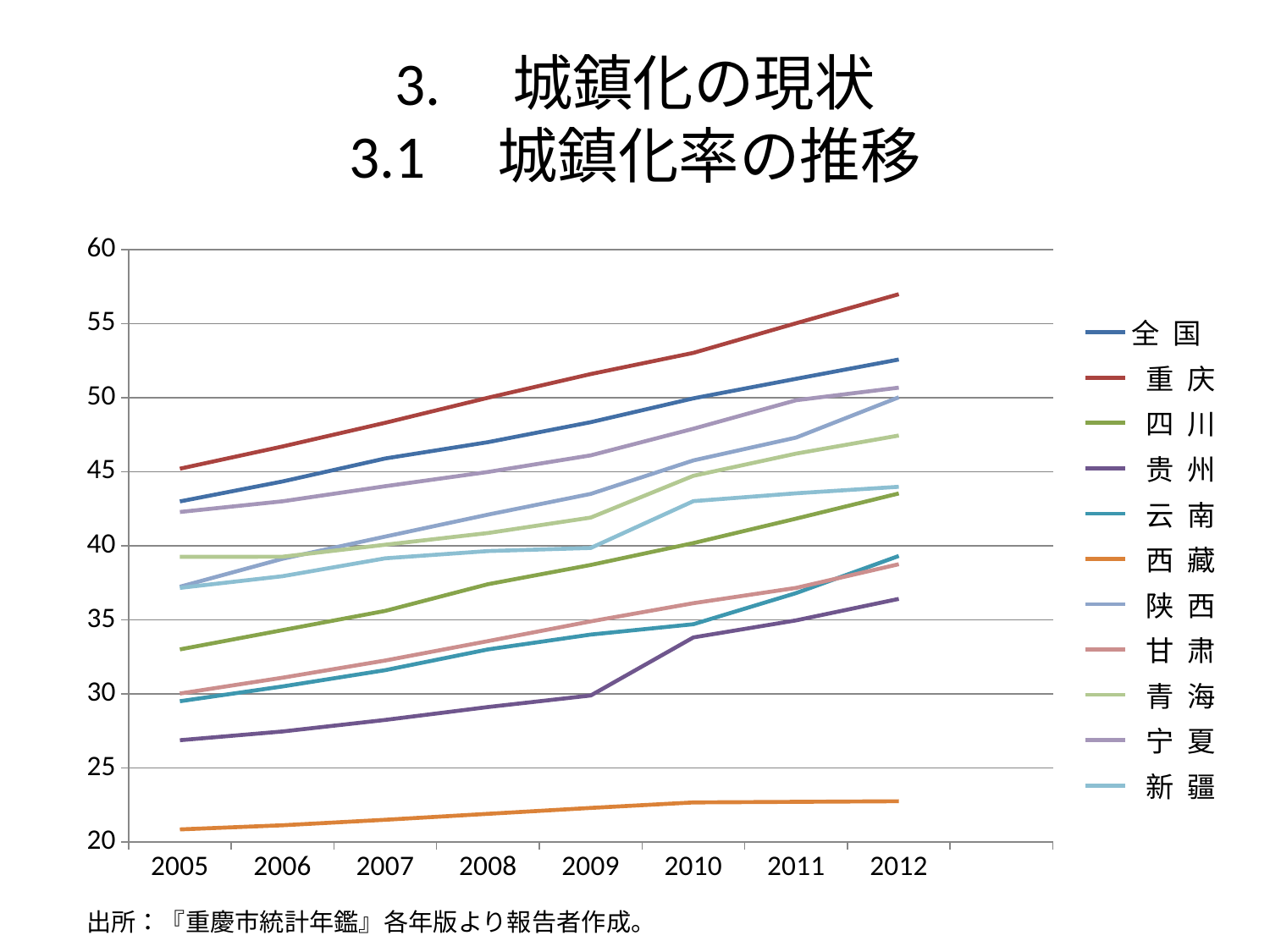
What is the highest value shown on the y axis? 60 What kind of chart is shown on the slide? line chart Is the value for 贵州 in 2005 greater or less than 30? less Which series has the highest value in 2012? 重庆 How many years are shown on the x axis? 8 Which is larger in 2012, the value for 青海 or the value for 新疆? 青海 Is the value for 重庆 in 2012 greater or less than 55? greater Is the value for 西藏 in 2005 greater or less than 25? less Which series has the lowest value in 2012? 西藏 How many series does the legend list? 11 Which is larger in 2012, the value for 全国 or the value for 四川? 全国 Does the value for 重庆 rise or fall from 2005 to 2012? rise